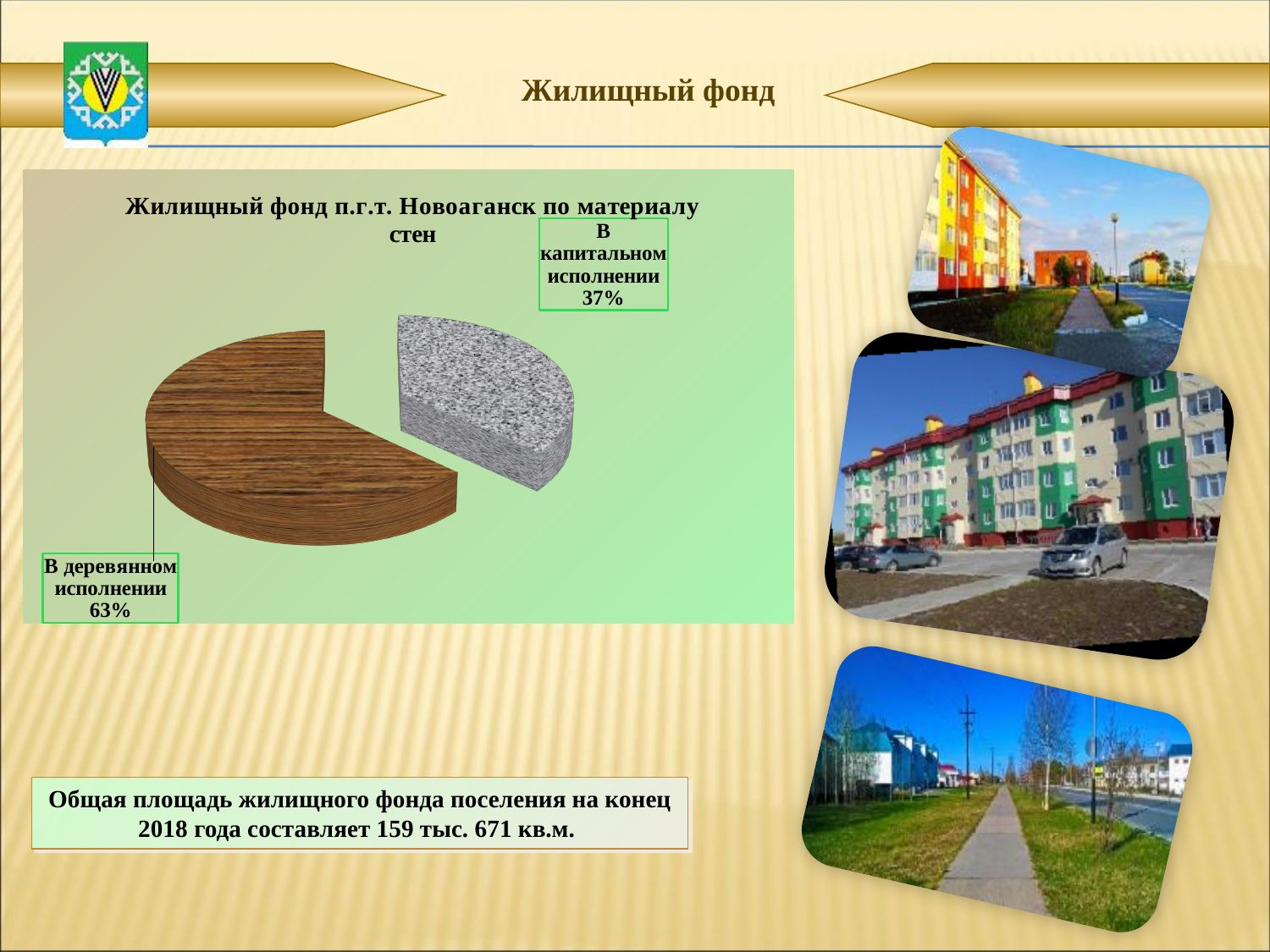
Is the share for "В капитальном исполнении" greater or less than 50%? less Which category has the largest share of the pie? В деревянном исполнении What share of the housing stock is "В деревянном исполнении"? 63% What is the title of the chart? Жилищный фонд п.г.т. Новоаганск по материалу стен What kind of chart is shown on the slide? Pie chart Which category has the smallest share of the pie? В капитальном исполнении Which is larger: the share for "В деревянном исполнении" or "В капитальном исполнении"? В деревянном исполнении How many slices does the pie chart have? 2 What texture is used for the "В деревянном исполнении" slice? Wood What share of the housing stock is "В капитальном исполнении"? 37% What is the difference in percentage points between the wooden and capital construction shares? 26